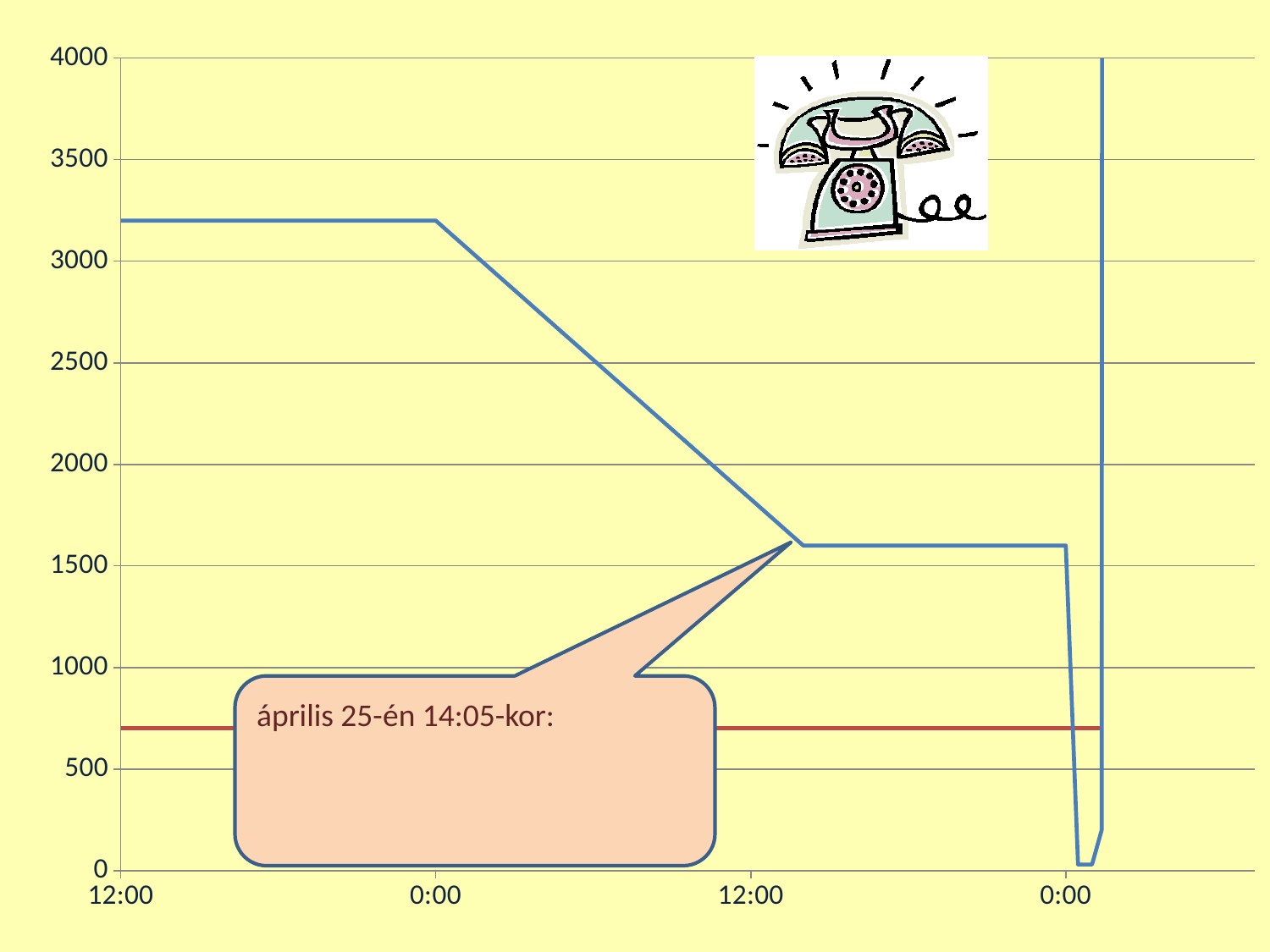
Is the value of the red horizontal line greater or less than 1000? less Is the value of the red horizontal line greater or less than 500? greater Is the value of the blue line at the second 12:00 tick greater or less than 2000? less What kind of chart is shown on the slide? line chart How many labelled ticks are there on the horizontal axis? 4 How many lines are plotted on the chart? 2 Does the blue line rise or fall between the first 0:00 tick and the second 12:00 tick? fall What text is written in the callout box on the chart? április 25-én 14:05-kor: At the first 12:00 tick, which is larger: the blue line or the red line? the blue line What is the highest value shown on the vertical axis? 4000